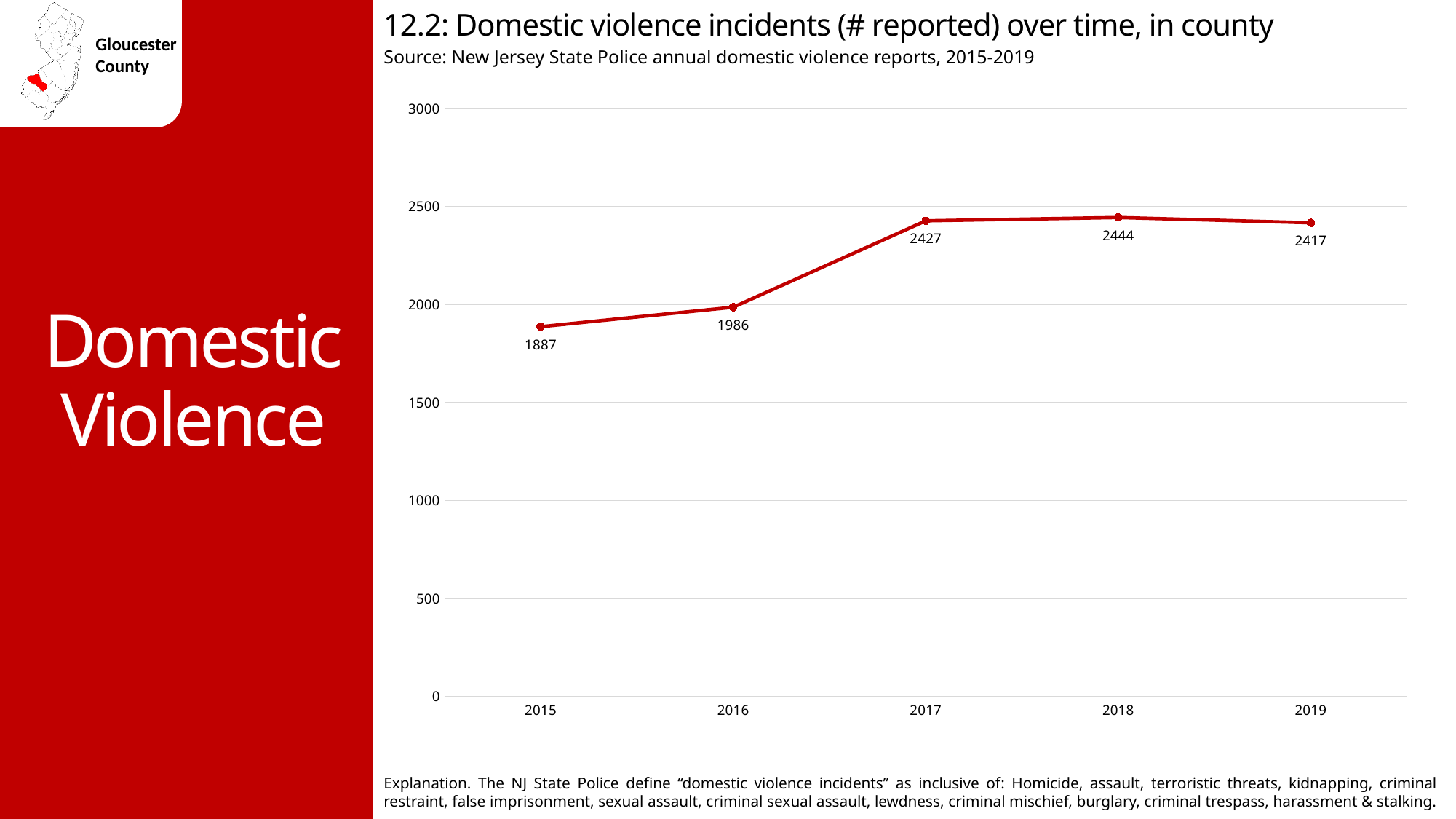
How many years are plotted on the chart? 5 Which year had more reported incidents, 2016 or 2017? 2017 Is the value for 2016 greater or less than 2000? less How many reported domestic violence incidents were there in 2015? 1887 What type of chart is shown on the slide? line chart What is the difference in reported incidents between 2018 and 2019? 27 Which year had the highest number of reported domestic violence incidents? 2018 Which year had the lowest number of reported domestic violence incidents? 2015 What is the difference in reported incidents between 2017 and 2016? 441 What is the value for 2019? 2417 How many reported domestic violence incidents were there in 2018? 2444 What is the overall trend in reported incidents from 2015 to 2019? rising